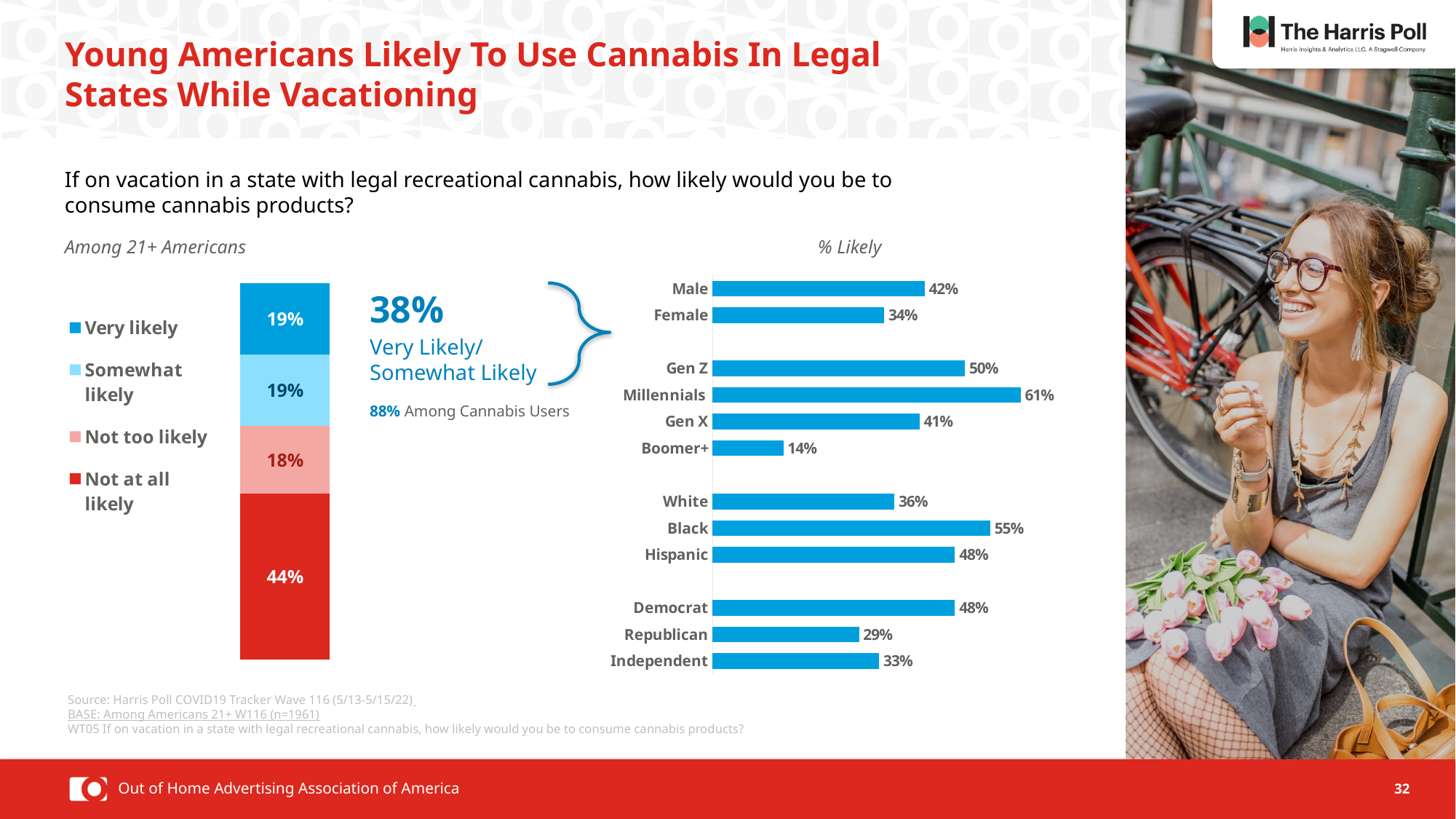
In the '% Likely' bar chart, which category has the lowest value? Boomer+ What kind of chart is the '% Likely' chart on the right? Bar chart In the '% Likely' bar chart, what is the value for Millennials? 61% In the stacked bar chart on the left ('Among 21+ Americans'), how many series does the legend list? 4 In the '% Likely' bar chart, which is larger, the value for Black or the value for White? Black In the '% Likely' bar chart, how many categories are plotted? 13 In the '% Likely' bar chart, what is the difference between the Male and Female values? 8% In the '% Likely' bar chart, which category has the highest value? Millennials In the stacked bar chart on the left ('Among 21+ Americans'), what is the value for 'Not too likely'? 18% In the stacked bar chart on the left ('Among 21+ Americans'), what is the value for 'Not at all likely'? 44% In the '% Likely' bar chart, what is the value for Republican? 29% In the stacked bar chart on the left ('Among 21+ Americans'), what is the total of the 'Very likely' and 'Somewhat likely' segments? 38%